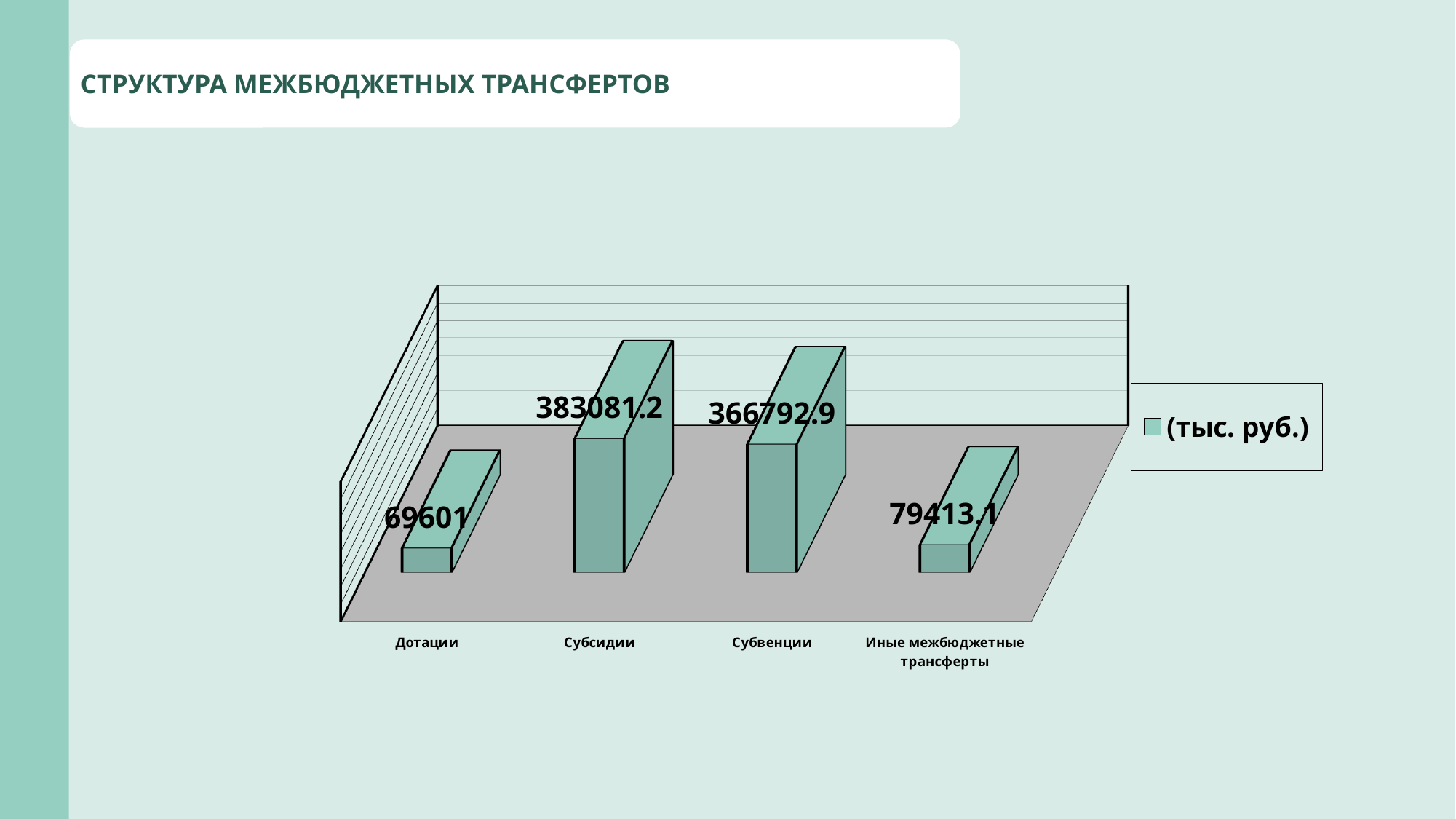
Which category has the lowest value? Дотации What is the value for Иные межбюджетные трансферты? 79413.1 Which category has the highest value? Субсидии How many categories are shown in the chart? 4 What is the legend entry shown for the chart? (тыс. руб.) What is the difference between the values for Субсидии and Субвенции? 16288.3 What is the value for Субсидии? 383081.2 What is the value for Субвенции? 366792.9 Which is larger, the value for Субвенции or the value for Иные межбюджетные трансферты? Субвенции What is the difference between the values for Иные межбюджетные трансферты and Дотации? 9812.1 What is the value for Дотации? 69601 What kind of chart is shown on the slide? Bar chart